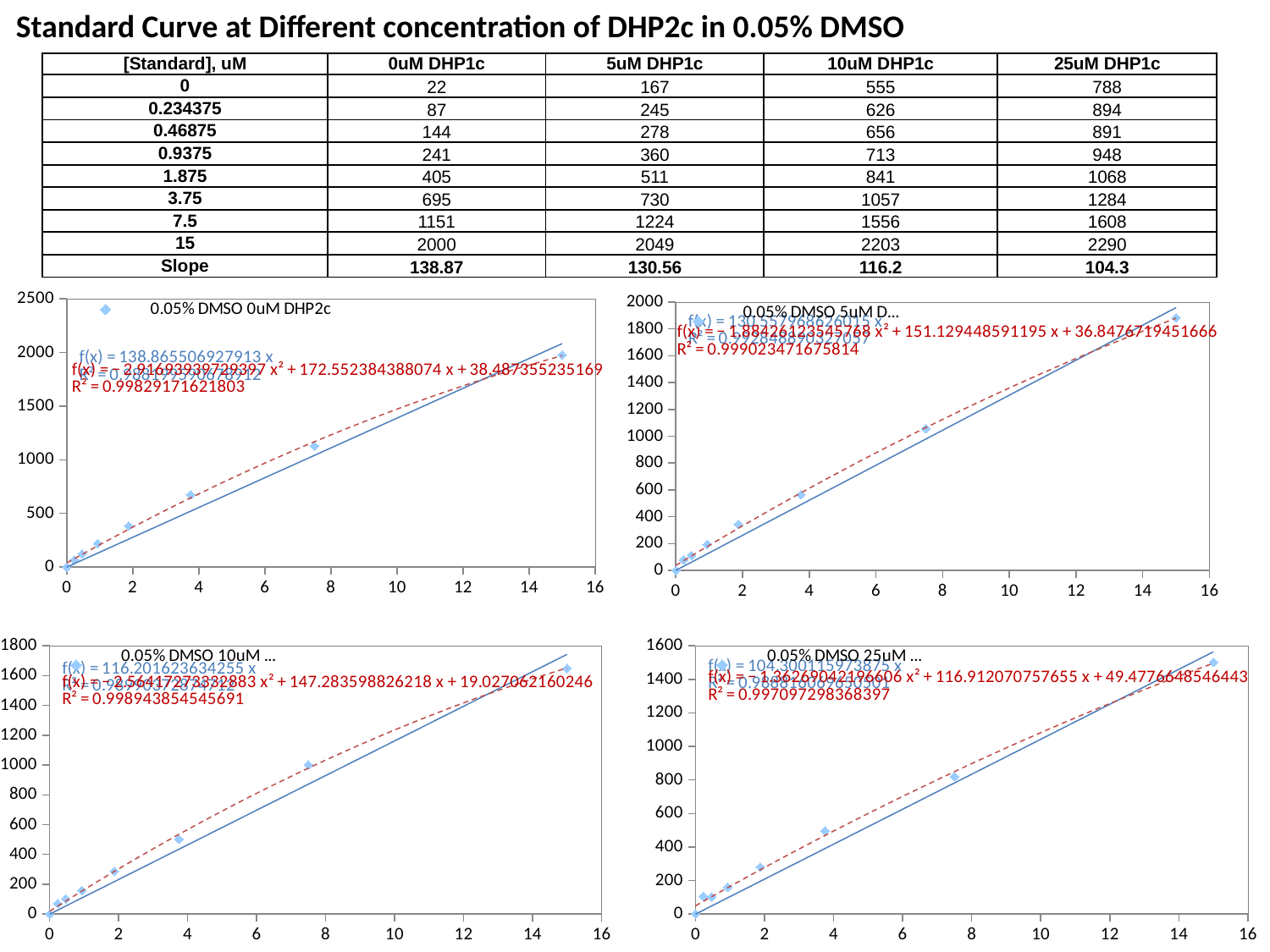
In the top-right chart (0.05% DMSO 5uM), is the value of the point at x = 7.5 greater or less than 1000? greater In the top-left chart (0.05% DMSO 0uM DHP2c), do the plotted values rise or fall as x increases? rise In the top-left chart (0.05% DMSO 0uM DHP2c), is the value of the point at x = 15 greater or less than 1500? greater In the bottom-left chart (0.05% DMSO 10uM), what is the slope shown in the linear trendline equation f(x)? 116.201623634255 In the top-right chart (0.05% DMSO 5uM), what R² value is printed in red? 0.999023471675814 What kind of chart is the top-left chart (0.05% DMSO 0uM DHP2c)? scatter chart In the bottom-left chart (0.05% DMSO 10uM), is the value of the point at x = 3.75 greater or less than 400? greater In the top-left chart (0.05% DMSO 0uM DHP2c), what is the slope shown in the linear trendline equation f(x)? 138.865506927913 In the top-left chart (0.05% DMSO 0uM DHP2c), how many data points are plotted? 8 What is the maximum value shown on the y axis of the top-left chart (0.05% DMSO 0uM DHP2c)? 2500 In the bottom-right chart (0.05% DMSO 25uM), what is the slope shown in the linear trendline equation f(x)? 104.300115973875